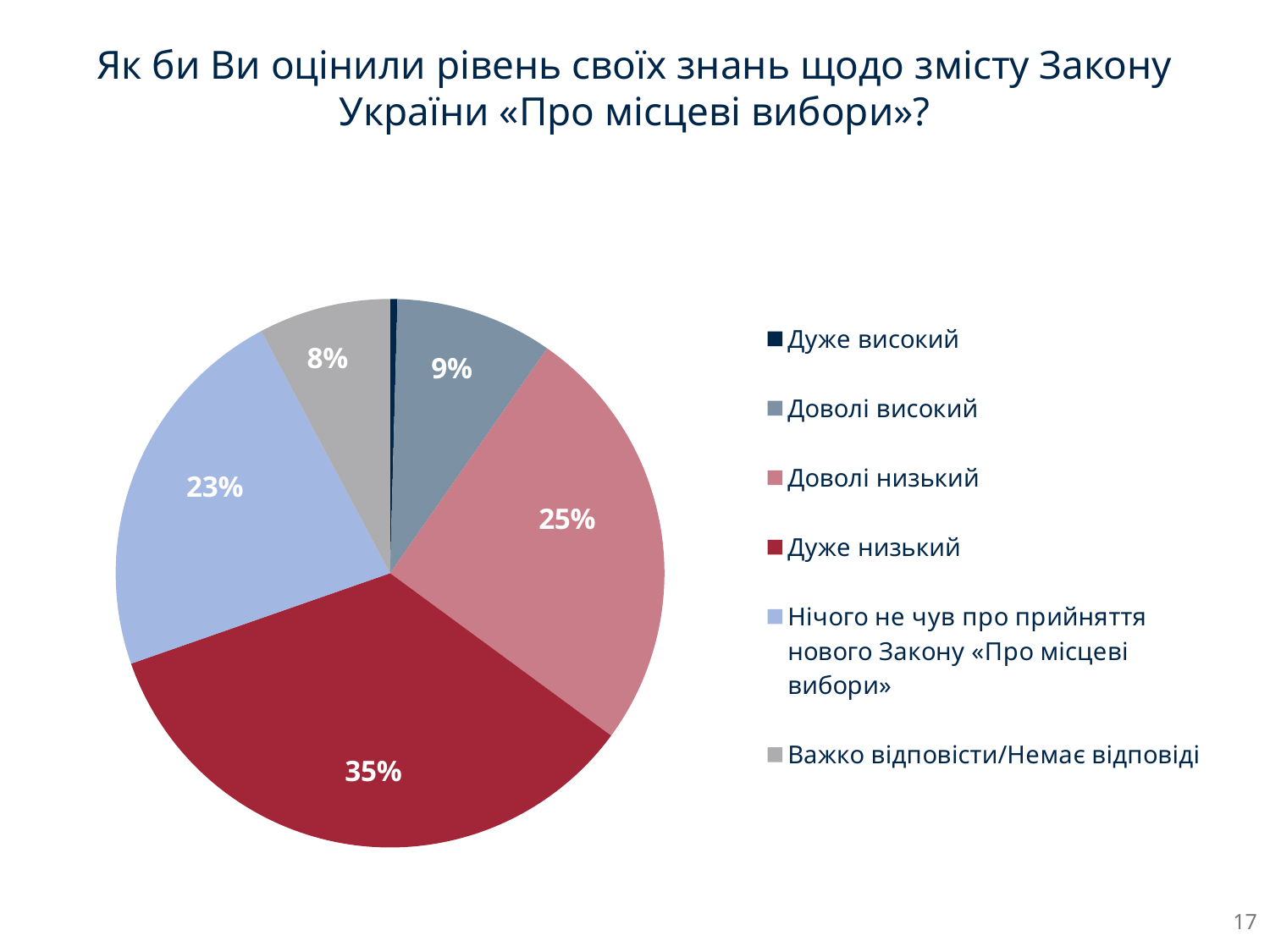
Which is larger: the share for «Доволі високий» or the share for «Важко відповісти/Немає відповіді»? Доволі високий Which answer option has the smallest share of the pie? Дуже високий What share of respondents answered «Доволі низький»? 25% By how many percentage points does «Дуже низький» exceed «Доволі низький»? 10 percentage points What kind of chart is shown on the slide? Pie chart What share of respondents answered «Дуже низький»? 35% What colour is the slice for «Дуже низький»? Dark red What share of respondents said they had heard nothing about the adoption of the new Law «Про місцеві вибори»? 23% What share of respondents answered «Важко відповісти/Немає відповіді»? 8% Which answer option has the largest share of the pie? Дуже низький How many answer categories does the pie chart show? 6 What share of respondents answered «Доволі високий»? 9%